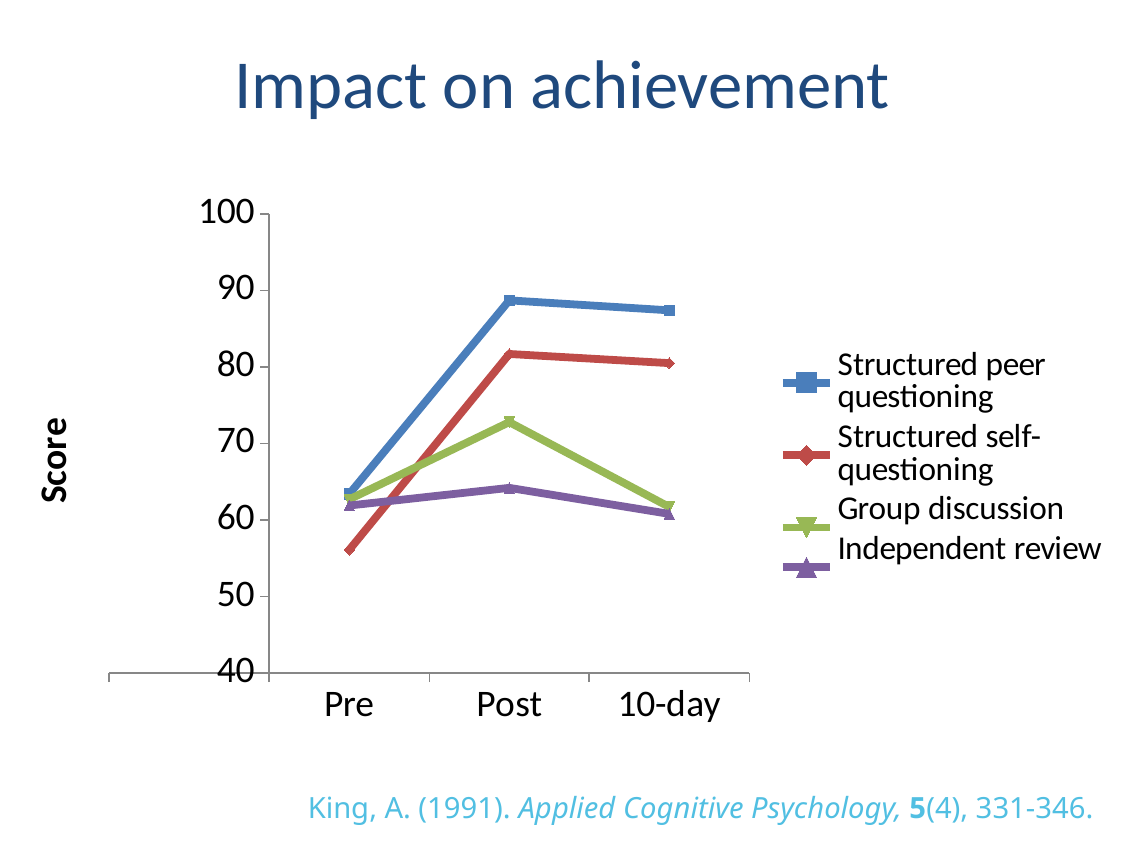
What kind of chart is shown on the slide? line chart Is the score for Independent review at Post greater or less than 70? less Which series has the lowest score at Pre? Structured self-questioning How many time points are shown on the x axis? 3 Is the score for Structured self-questioning at Pre greater or less than 60? less How many series does the legend list? 4 Which series has the lowest score at Post? Independent review At 10-day, which is higher: Structured self-questioning or Group discussion? Structured self-questioning Is the score for Structured peer questioning at Post greater or less than 80? greater Does the score for Group discussion rise or fall from Post to 10-day? fall Which series has the highest score at Post? Structured peer questioning What is the label on the vertical axis? Score